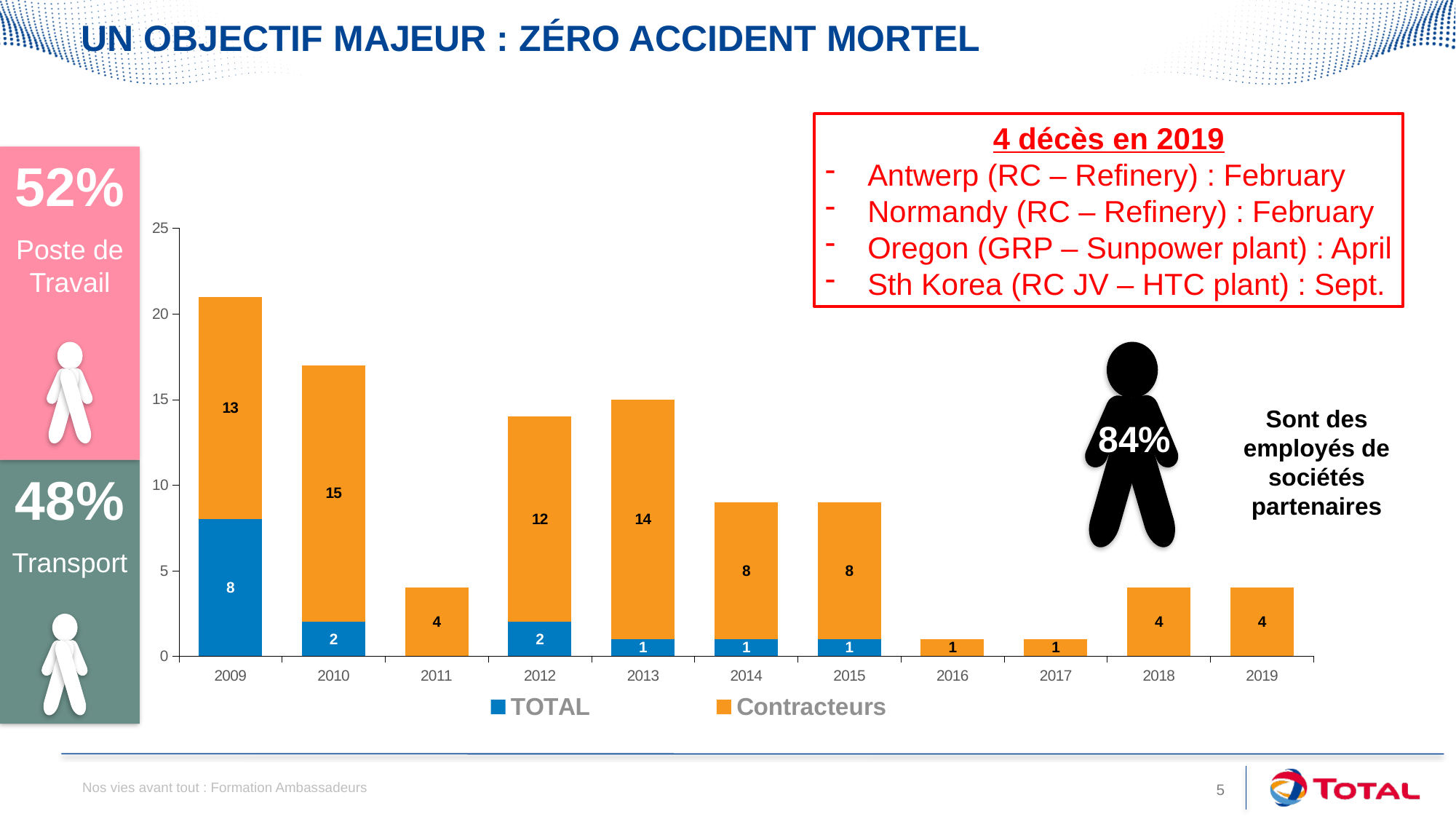
What is the Contracteurs value for 2010? 15 What is the TOTAL value for 2009? 8 How many series does the chart legend list? 2 How many years are shown on the x axis of the chart? 11 Which series is shown in orange in the chart? Contracteurs Which is larger, the Contracteurs value for 2012 or for 2018? 2012 What is the Contracteurs value for 2019? 4 Which year has the highest stacked bar? 2009 What type of chart is shown on the slide? stacked bar chart What is the difference between the Contracteurs values for 2013 and 2014? 6 What is the total of the stacked bar for 2009? 21 Is the stacked bar for 2010 greater or less than 15? greater